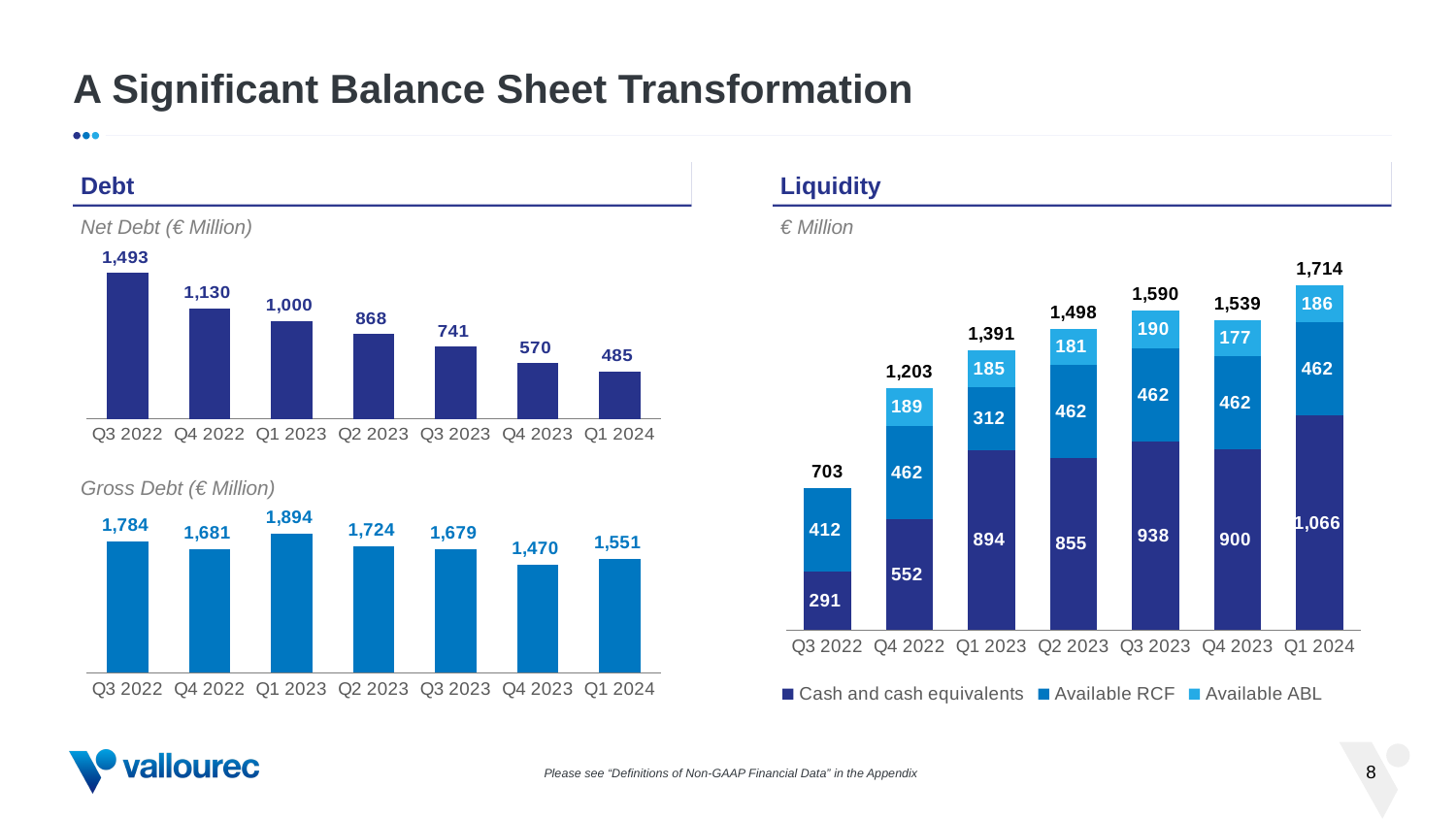
In the Liquidity chart, what is the total of the stacked bar for Q3 2023? 1,590 In the Liquidity chart, which is larger: Available RCF for Q1 2023 or Available RCF for Q2 2023? Q2 2023 What kind of chart is the Liquidity chart? stacked bar chart In the Net Debt chart, do the values rise or fall from Q3 2022 to Q1 2024? fall In the Gross Debt chart, which quarter has the highest value? Q1 2023 In the Net Debt chart, what is the difference between Q3 2022 and Q1 2024? 1,008 In the Gross Debt chart, which quarter has the lowest value? Q4 2023 In the Net Debt chart, which quarter has the highest value? Q3 2022 In the Liquidity chart, how many series does the legend list? 3 In the Net Debt chart, what is the value for Q1 2024? 485 In the Gross Debt chart, what is the value for Q2 2023? 1,724 In the Liquidity chart, what is the Cash and cash equivalents value for Q1 2024? 1,066